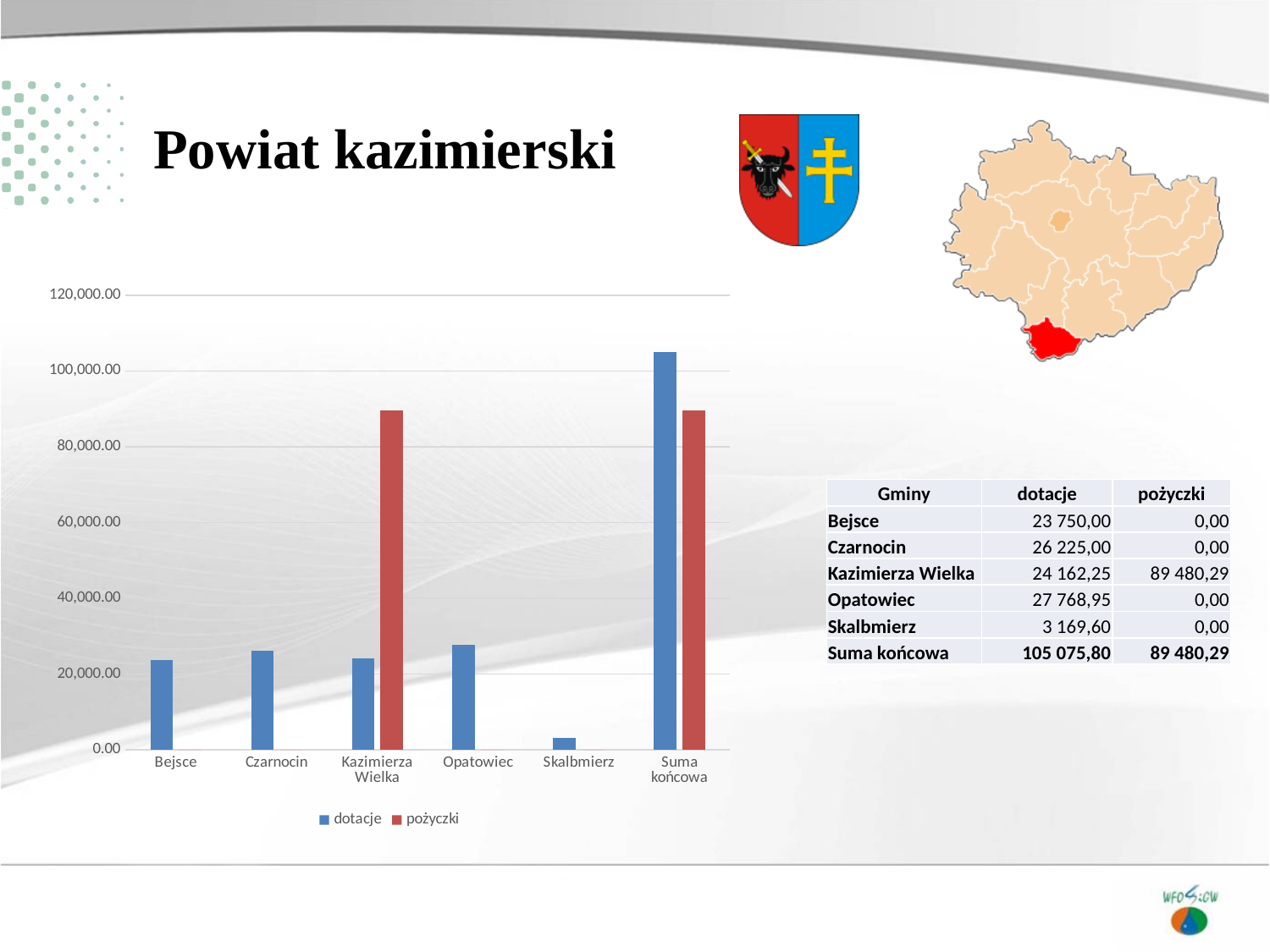
How many series does the chart legend list? 2 Is the dotacje bar for Suma końcowa greater or less than 100,000.00? greater What is the difference between the dotacje values for Czarnocin and Bejsce? 2 475,00 Excluding Suma końcowa, which gmina has the highest dotacje value? Opatowiec According to the table, what is the pożyczki value for Kazimierza Wielka? 89 480,29 What kind of chart is shown on the slide? bar chart Which colour represents the pożyczki series in the chart? red How many categories are shown on the x axis of the chart? 6 Which is larger, the dotacje value for Bejsce or for Czarnocin? Czarnocin According to the table, what is the dotacje value for Czarnocin? 26 225,00 Excluding Suma końcowa, which gmina has the lowest dotacje value? Skalbmierz What is the dotacje value for Suma końcowa shown in the table? 105 075,80